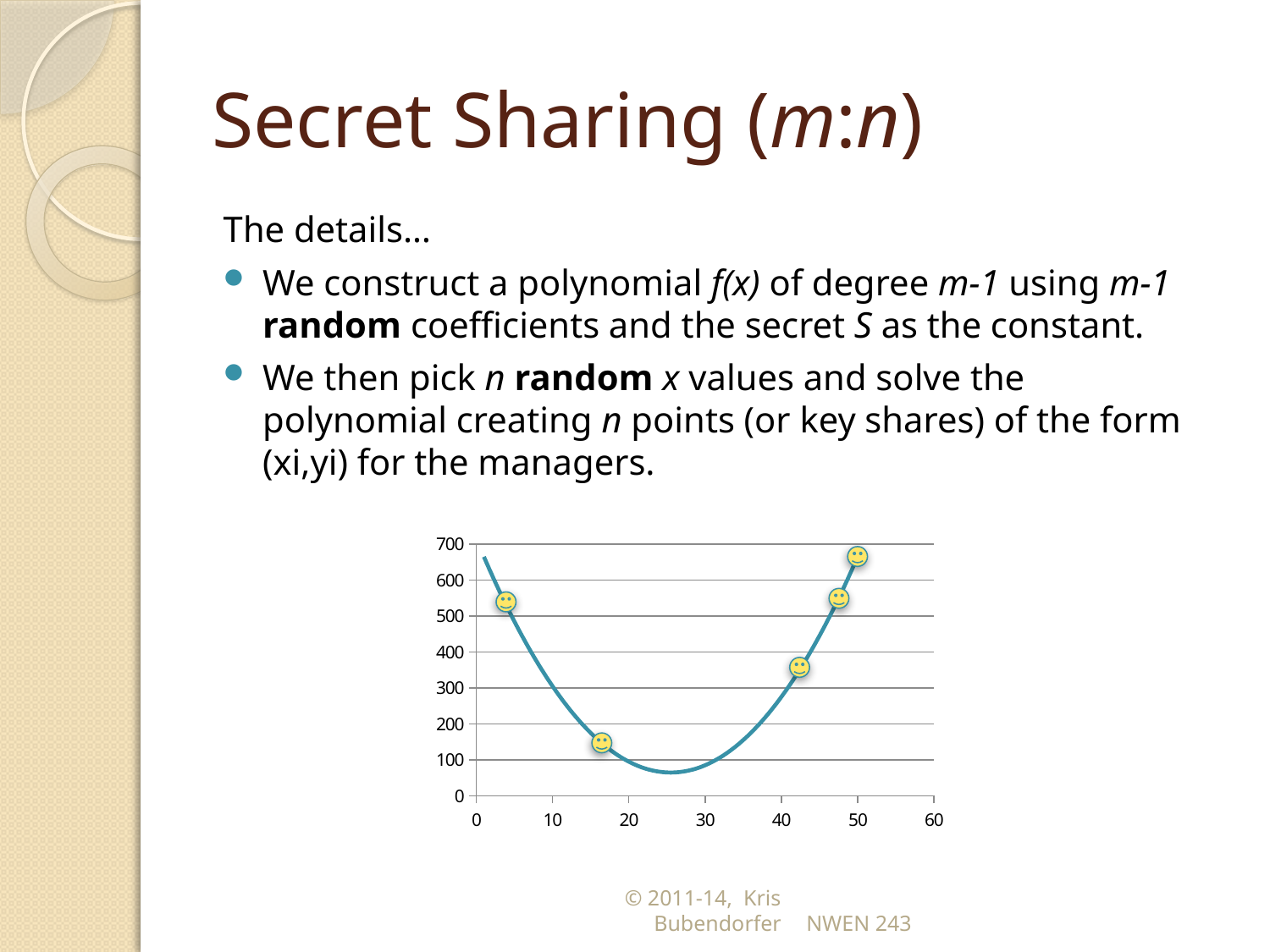
What is the highest value shown on the y axis? 700 Is the value of the marked point near x = 4 greater or less than 500? greater Which marked point has the highest y value? the one near x = 50 Which marked point has the lowest y value? the one near x = 16 Is the value of the marked point near x = 50 greater or less than 600? greater What kind of chart is shown on the slide? line chart Is the value of the marked point near x = 16 greater or less than 200? less Does the curve rise or fall as x increases from 0 to 20? fall How many marked points (smiley faces) are plotted on the curve? 5 What is the highest value shown on the x axis? 60 Which marked point has the highest y value, the one near x = 16 or the one near x = 50? the one near x = 50